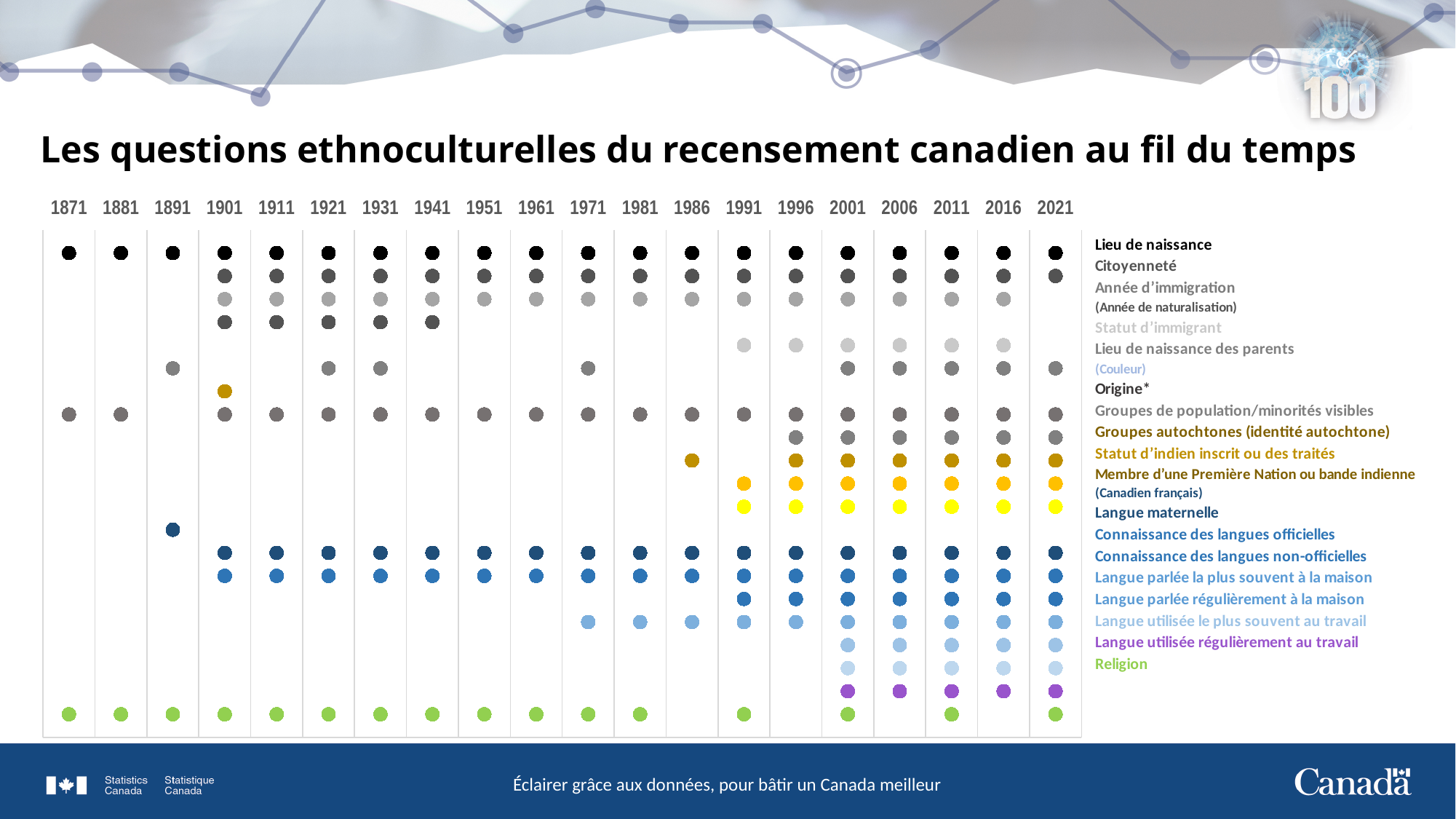
How many question topics are listed in the legend on the right of the chart? 21 What colour are the dots for the 'Religion' row? Green Is there a 'Religion' dot in the 2021 column? Yes What is the earliest census year shown on the chart? 1871 Which census years after 1981 have a 'Religion' dot? 1991, 2001, 2011, 2021 Does the 'Lieu de naissance' row have a dot in every census year shown? Yes What is the title of the chart? Les questions ethnoculturelles du recensement canadien au fil du temps Is there a 'Religion' dot in the 1986 column? No What kind of chart is shown on the slide? Dot matrix chart How many census years are shown along the top of the chart? 20 How many dots are plotted in the 1871 column? 3 What is the most recent census year shown on the chart? 2021